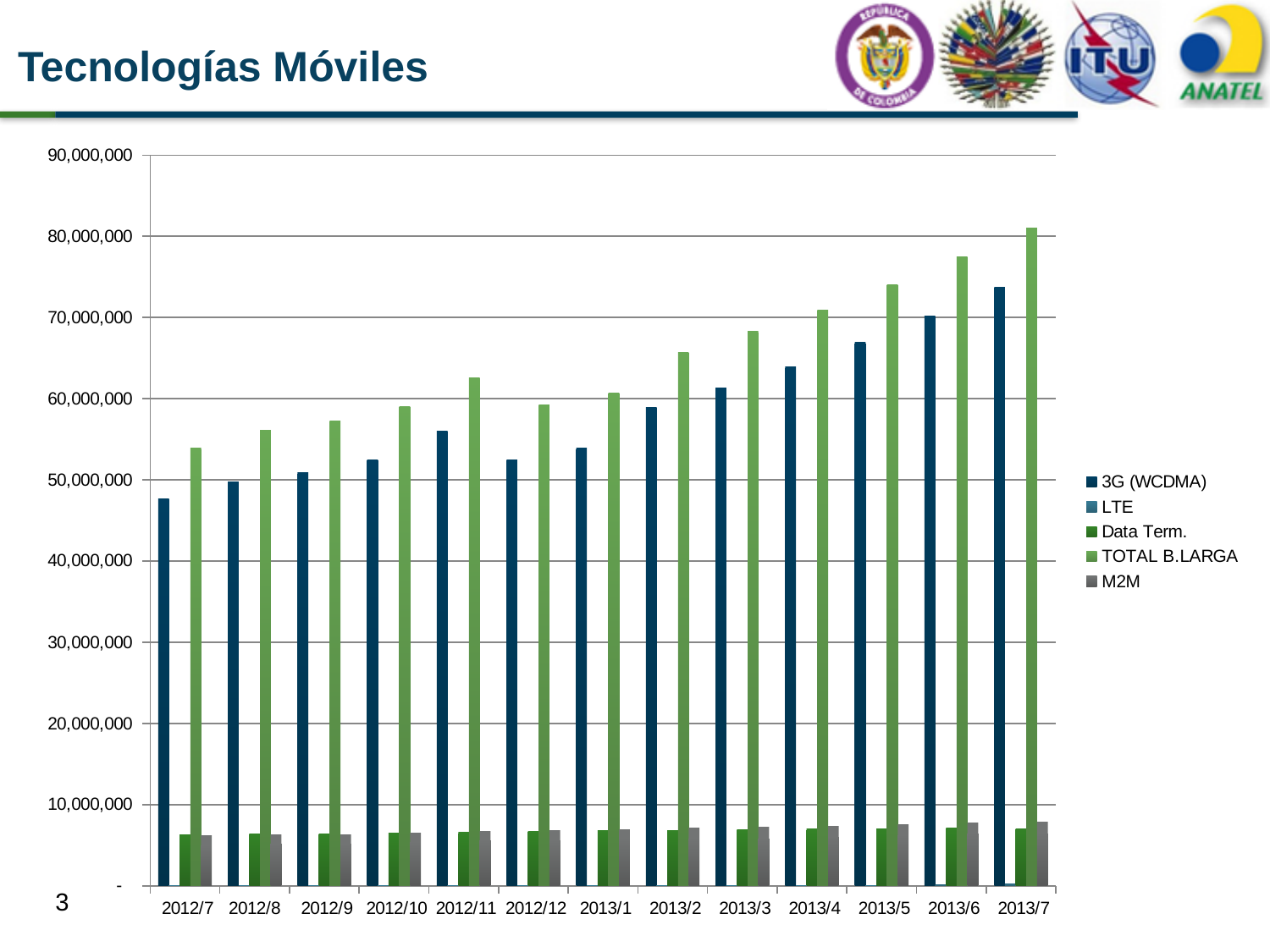
How many time periods are shown along the x axis? 13 Is the 3G (WCDMA) value for 2013/7 greater or less than 70,000,000? greater Is the 3G (WCDMA) value for 2012/7 greater or less than 50,000,000? less How many series does the legend list? 5 What kind of chart is shown on the slide? bar chart Is the Data Term. value for 2012/7 greater or less than 10,000,000? less What is the title of the slide containing the chart? Tecnologías Móviles In which period is the 3G (WCDMA) value lowest? 2012/7 In which period is the TOTAL B.LARGA value highest? 2013/7 In 2013/7, which is larger: 3G (WCDMA) or TOTAL B.LARGA? TOTAL B.LARGA Does the TOTAL B.LARGA series rise or fall from 2012/7 to 2013/7? rise